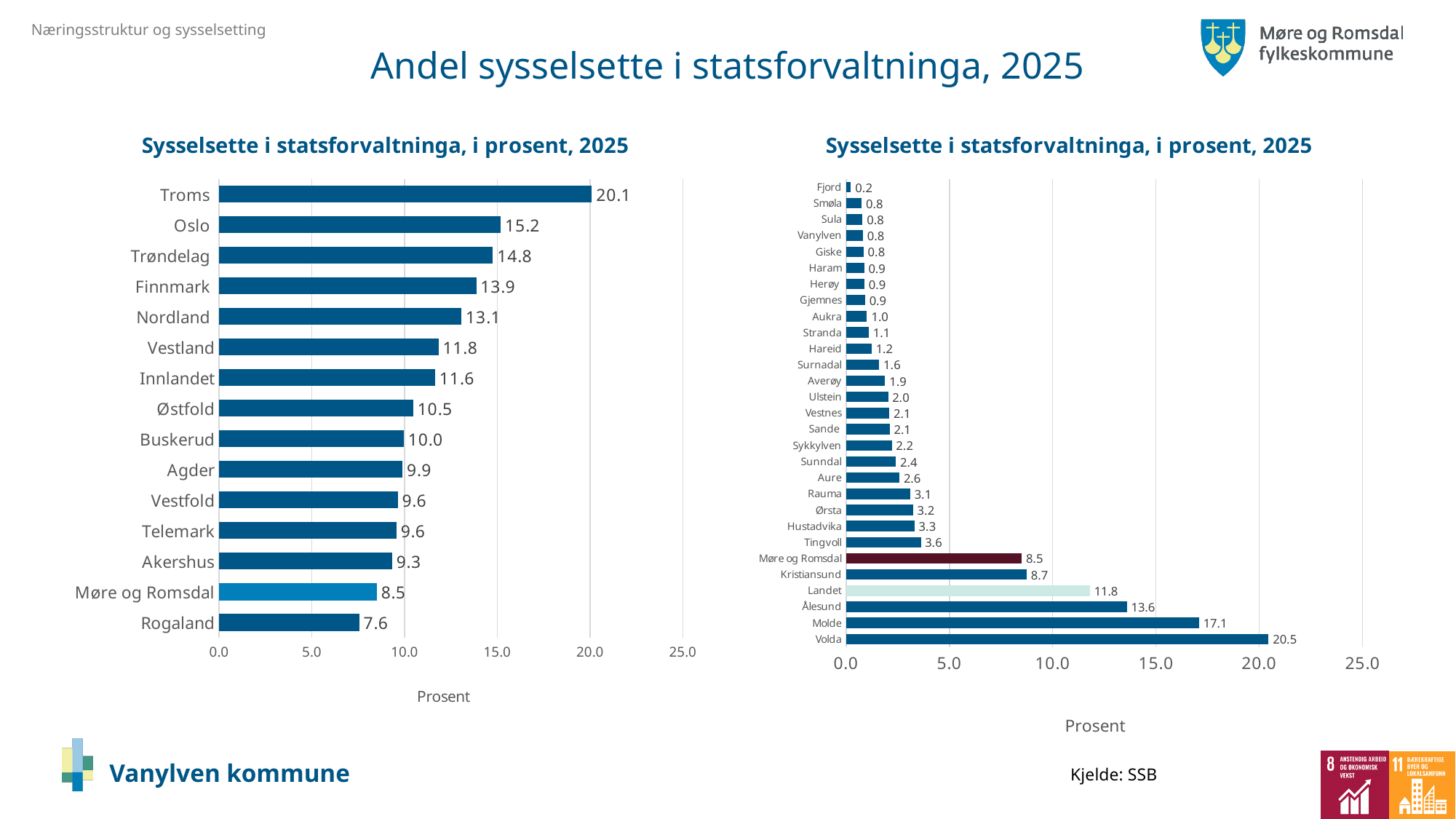
In the right chart, what is the difference between Molde and Ålesund? 3.5 In the left chart, how many categories are shown? 15 In the right chart, which category has the highest value? Volda In the left chart, what is the value for Troms? 20.1 In the right chart, what is the value for Volda? 20.5 What kind of chart is the left chart? Bar chart In the right chart, how many categories are shown? 29 In the right chart, what is the value for Vanylven? 0.8 In the left chart, what is the difference between Oslo and Møre og Romsdal? 6.7 In the right chart, which category has the lowest value? Fjord In the left chart, which is larger, Finnmark or Nordland? Finnmark In the left chart, which category has the lowest value? Rogaland